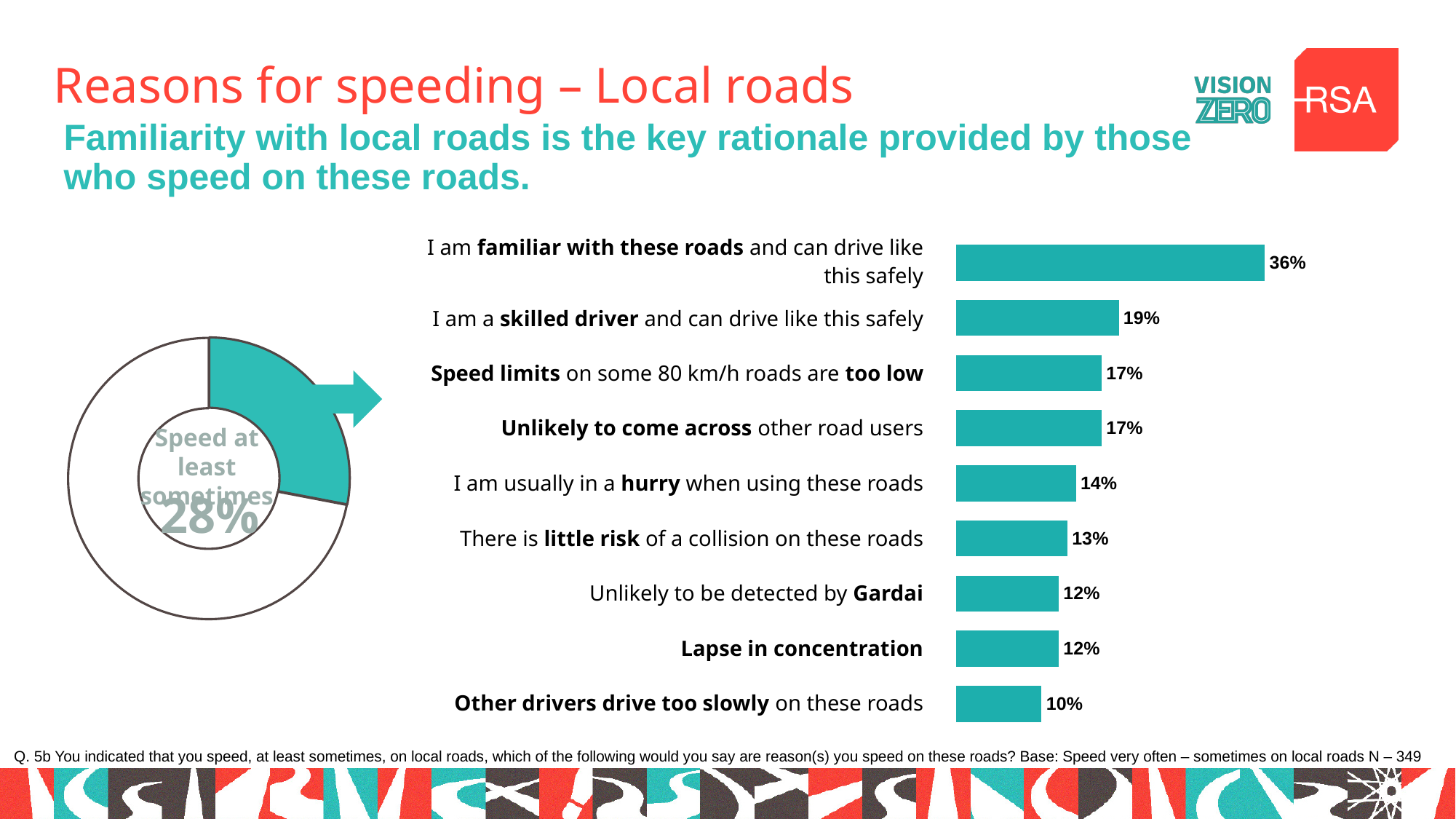
In the bar chart on the right, which is larger: the value for 'I am usually in a hurry when using these roads' or the value for 'There is little risk of a collision on these roads'? I am usually in a hurry when using these roads In the bar chart on the right, what percentage cited 'Lapse in concentration'? 12% What type of chart is shown on the right side of the slide? Bar chart In the donut chart on the left, what percentage speed at least sometimes on local roads? 28% In the bar chart on the right, which reason has the highest percentage? I am familiar with these roads and can drive like this safely In the bar chart on the right, what is the value for 'I am a skilled driver and can drive like this safely'? 19% In the bar chart on the right, what is the difference between the percentage for 'familiar with these roads' and the percentage for 'skilled driver'? 17% How many reasons are listed in the bar chart on the right? 9 In the bar chart on the right, which reason has the lowest percentage? Other drivers drive too slowly on these roads In the bar chart on the right, what percentage of respondents said they are familiar with these roads and can drive like this safely? 36% In the bar chart on the right, what is the difference between the value for 'Unlikely to be detected by Gardai' and the value for 'Other drivers drive too slowly on these roads'? 2% What type of chart is shown on the left side of the slide? Donut chart